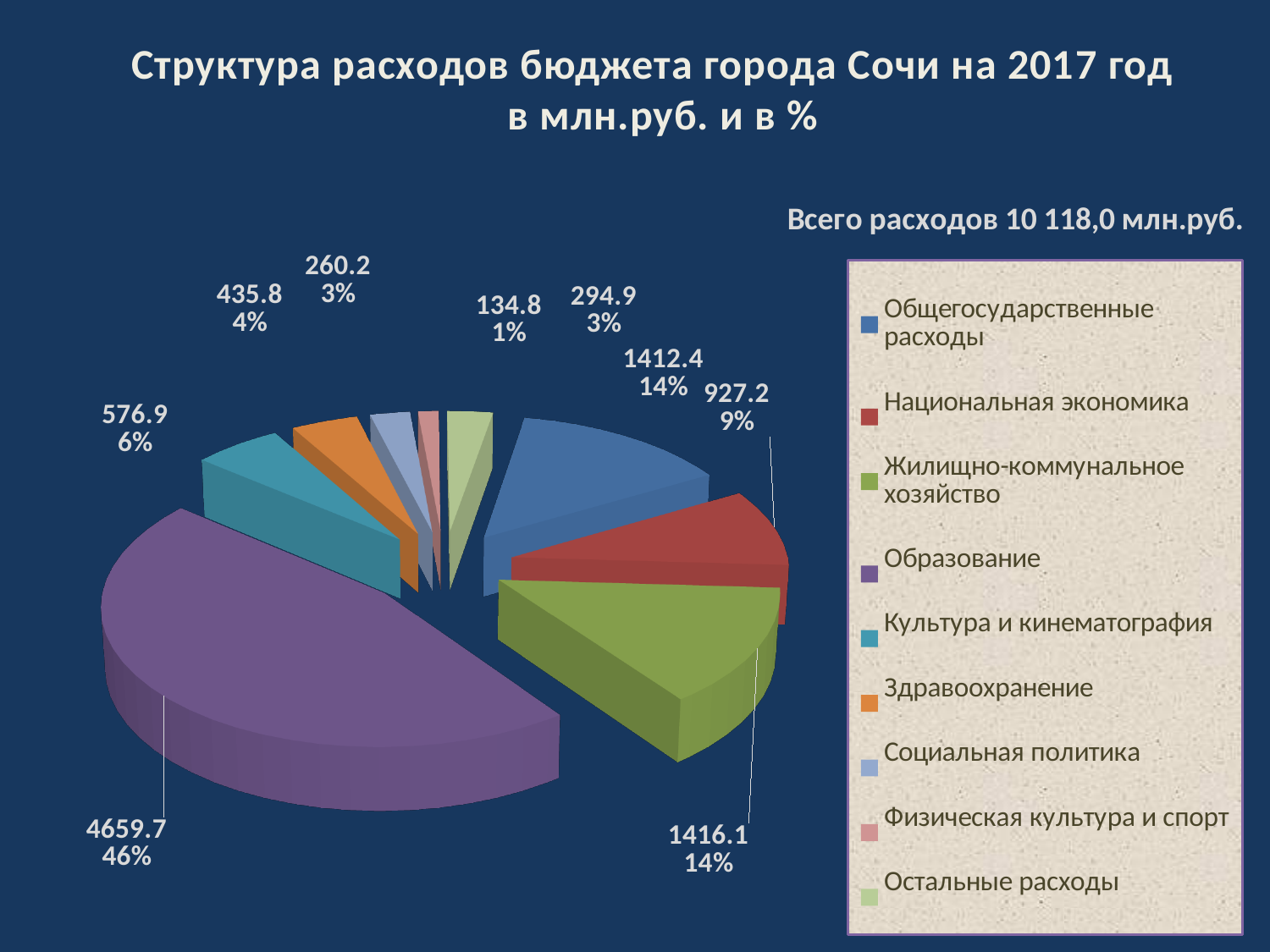
Which category has the smallest slice? Физическая культура и спорт What kind of chart is shown on the slide? pie chart What is the value for Национальная экономика? 927.2 What share of the pie does Жилищно-коммунальное хозяйство take? 14% What is the value for Образование? 4659.7 How many categories does the pie chart have? 9 What is the difference between the values for Здравоохранение and Социальная политика? 175.6 What total expenditure amount is stated on the slide? 10 118,0 млн.руб. Which category has the largest slice? Образование Which is larger, Образование or Жилищно-коммунальное хозяйство? Образование What share of the pie does Здравоохранение take? 4% What is the value for Культура и кинематография? 576.9